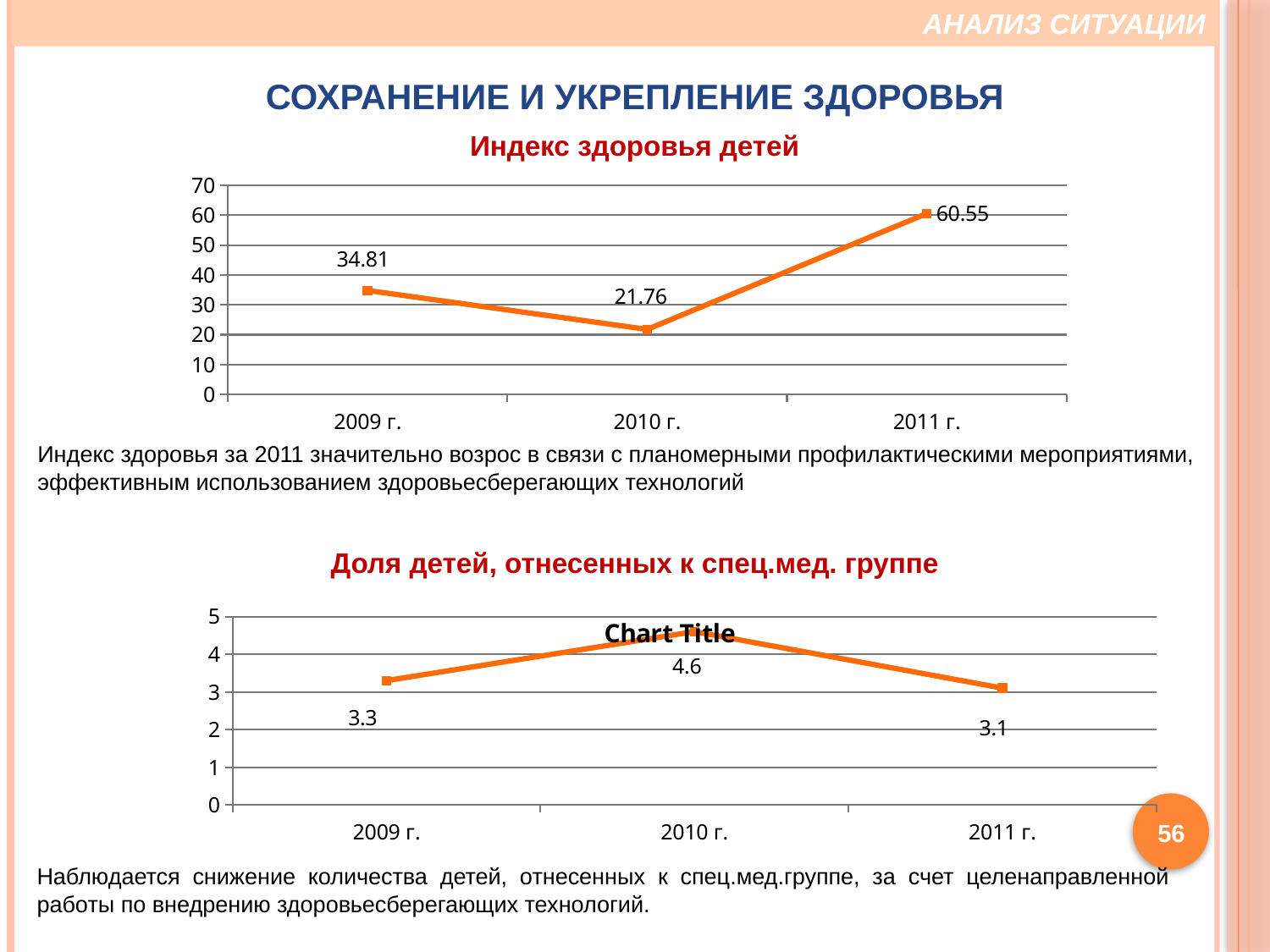
In the chart 'Доля детей, отнесенных к спец.мед. группе', what is the value for 2011 г.? 3.1 In the chart 'Индекс здоровья детей', what is the value for 2011 г.? 60.55 In the chart 'Индекс здоровья детей', what is the difference between the values for 2011 г. and 2009 г.? 25.74 In the chart 'Индекс здоровья детей', which year has the lowest value? 2010 г. What type of chart is 'Индекс здоровья детей'? Line chart In the chart 'Доля детей, отнесенных к спец.мед. группе', which year has the highest value? 2010 г. In the chart 'Доля детей, отнесенных к спец.мед. группе', what is the value for 2010 г.? 4.6 In the chart 'Индекс здоровья детей', which year has the highest value? 2011 г. In the chart 'Индекс здоровья детей', how many data points are plotted? 3 In the chart 'Индекс здоровья детей', what is the value for 2010 г.? 21.76 In the chart 'Доля детей, отнесенных к спец.мед. группе', what is the difference between the values for 2010 г. and 2009 г.? 1.3 In the chart 'Доля детей, отнесенных к спец.мед. группе', is the value for 2009 г. larger or smaller than the value for 2011 г.? Larger